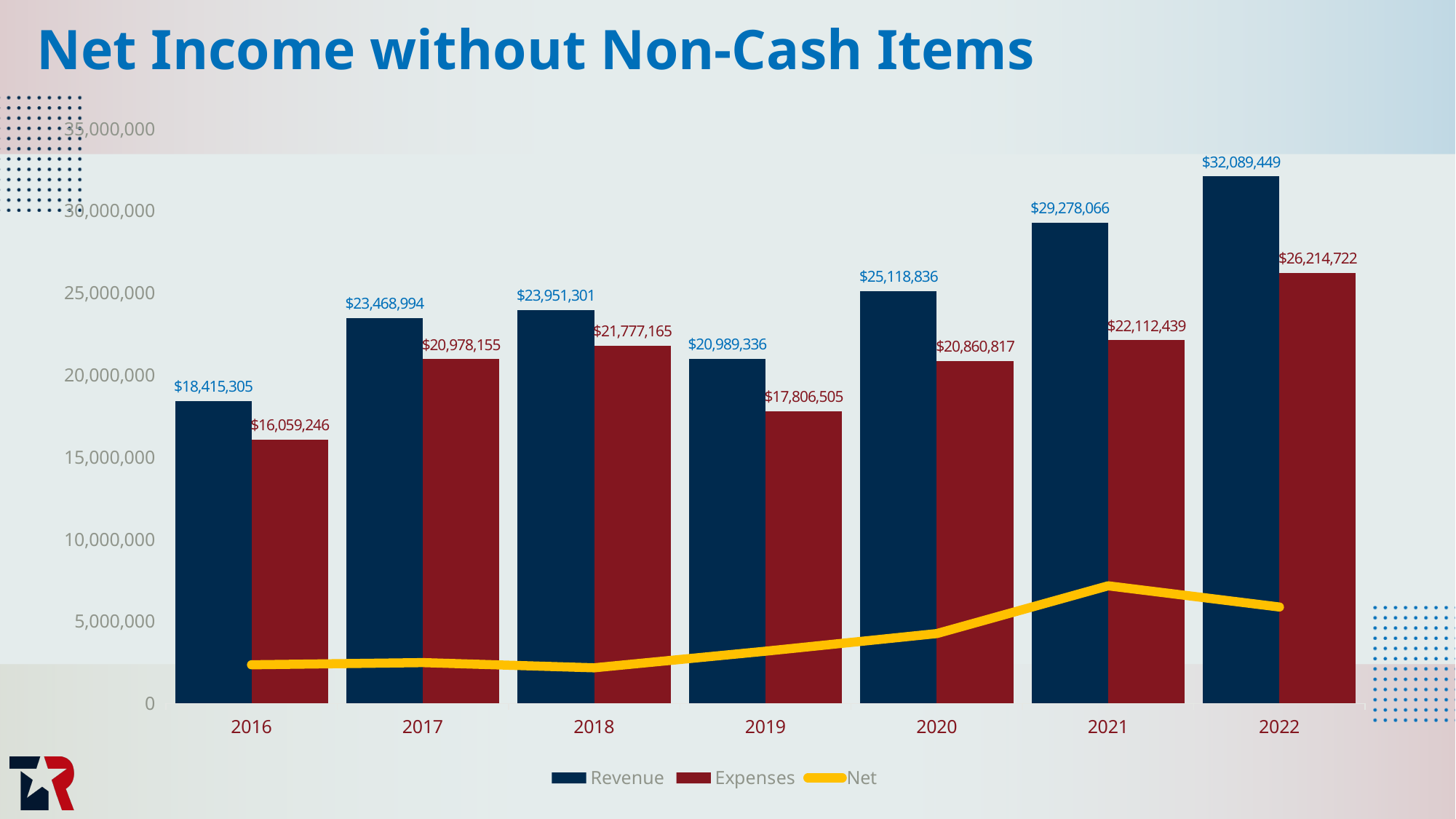
What is the Expenses value for 2019? $17,806,505 What is the difference between Revenue and Expenses in 2022? $5,874,727 What is the Revenue value for 2016? $18,415,305 How many series does the legend list? 3 What is the Revenue value for 2022? $32,089,449 Which is larger, Revenue in 2018 or Revenue in 2019? Revenue in 2018 What is the difference between Revenue and Expenses in 2016? $2,356,059 Which year has the highest Revenue? 2022 Is the Net value for 2021 greater or less than 5,000,000? greater How many years are shown on the x axis? 7 What is the title of the chart? Net Income without Non-Cash Items Which year has the lowest Expenses? 2016